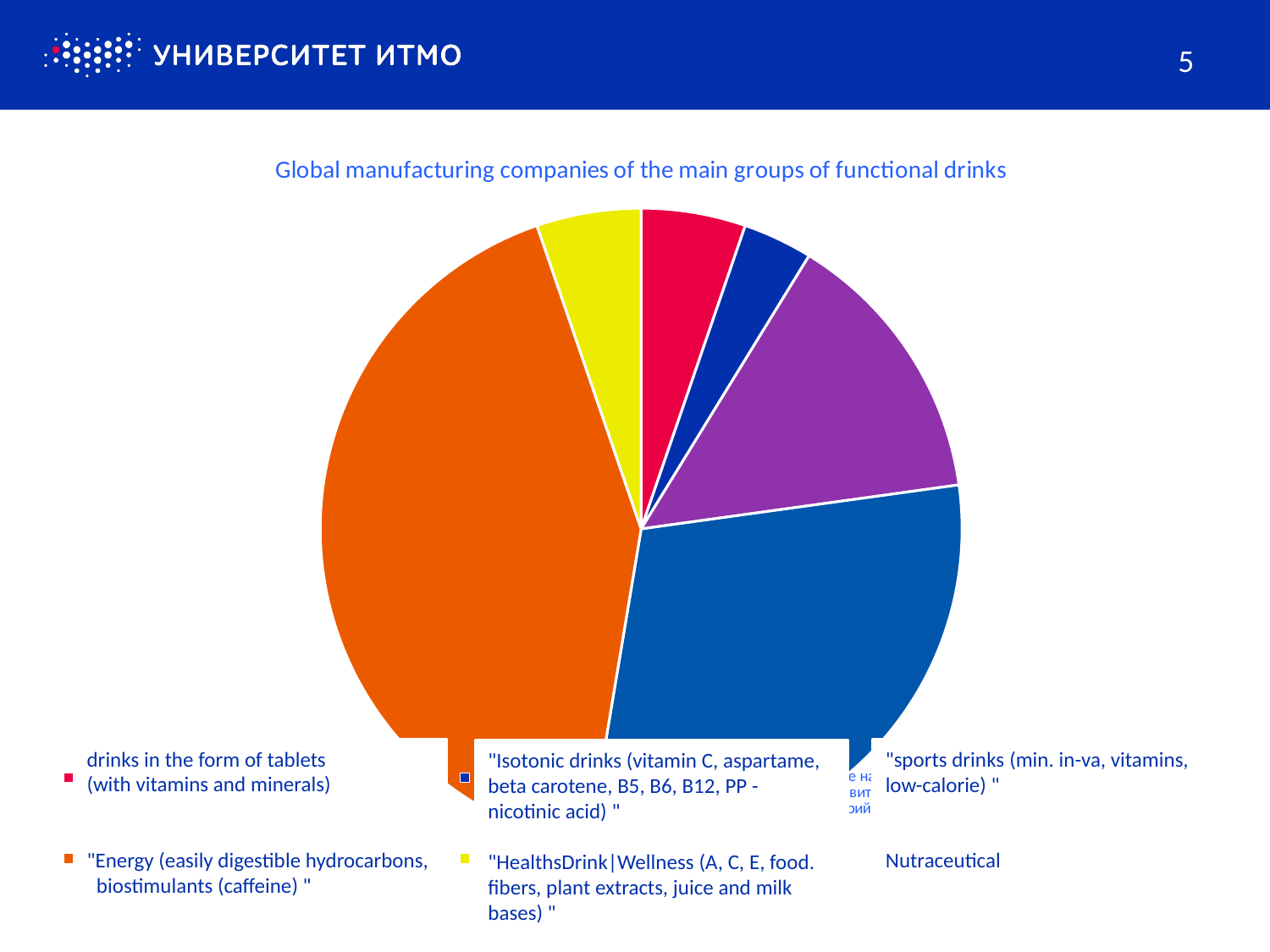
Which category has the largest slice of the pie? HealthsDrink|Wellness (A, C, E, food. fibers, plant extracts, juice and milk bases) Which slice is larger: Energy or Isotonic drinks? Energy Which slice is larger: drinks in the form of tablets or Isotonic drinks? drinks in the form of tablets How many entries does the legend list? 6 What kind of chart is shown on the slide? pie chart Which slice is larger: Energy or HealthsDrink|Wellness? HealthsDrink|Wellness How many slices does the pie chart have? 6 Which category has the smallest slice of the pie? Isotonic drinks (vitamin C, aspartame, beta carotene, B5, B6, B12, PP - nicotinic acid) What is the title of the chart? Global manufacturing companies of the main groups of functional drinks